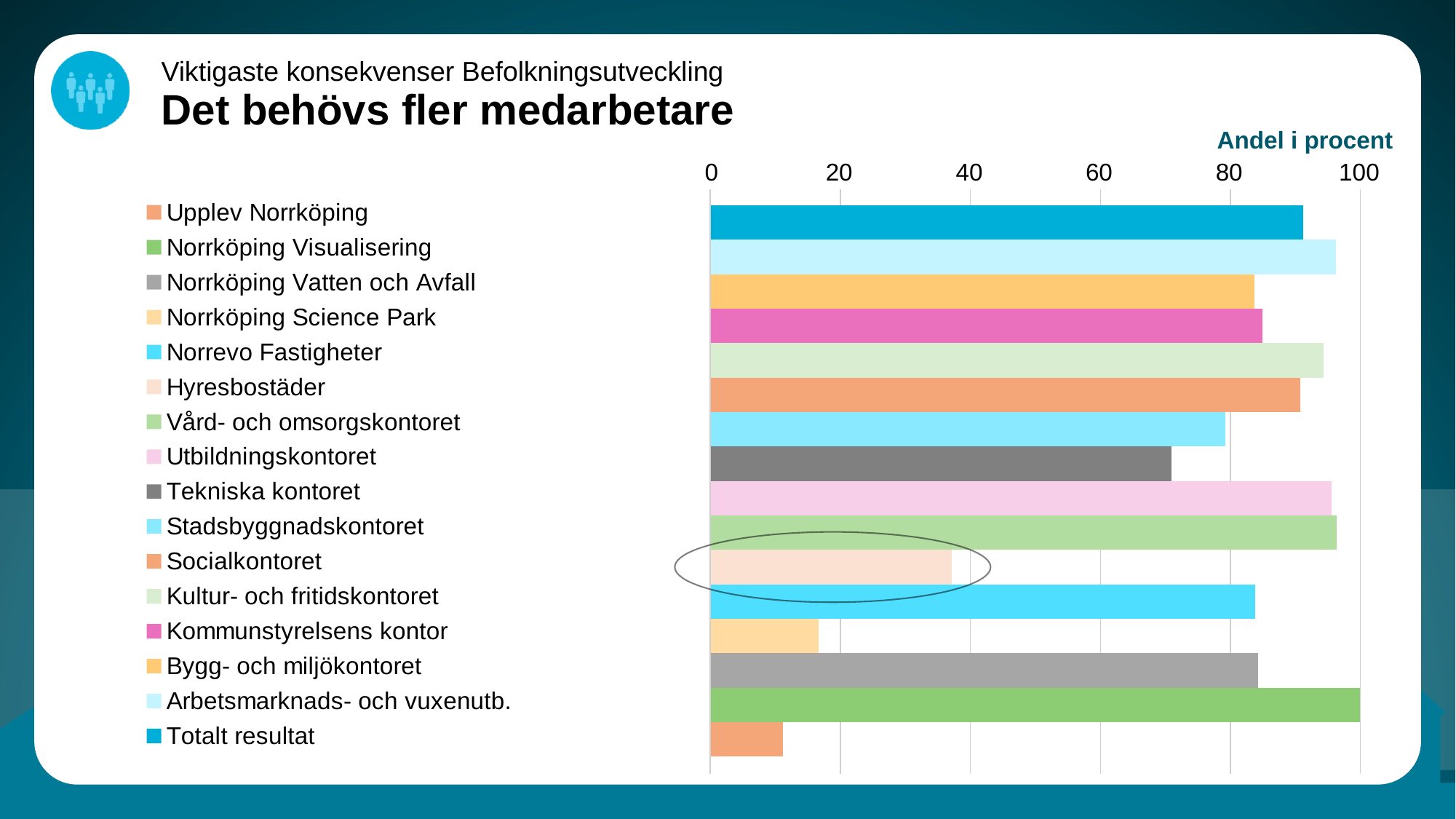
What kind of chart is shown on the slide? bar chart Is the value for Tekniska kontoret greater or less than 80? less What label is shown above the horizontal axis of the chart? Andel i procent Is the value for Norrköping Science Park greater or less than 20? less How many categories does the legend of the chart list? 16 Which is larger, the value for Vård- och omsorgskontoret or the value for Tekniska kontoret? Vård- och omsorgskontoret Which category has the lowest value in the chart? Upplev Norrköping Which category has the highest value in the chart? Norrköping Visualisering Which category's bar is circled on the chart? Hyresbostäder What is the value for Norrköping Visualisering? 100 Is the value for Hyresbostäder greater or less than 60? less